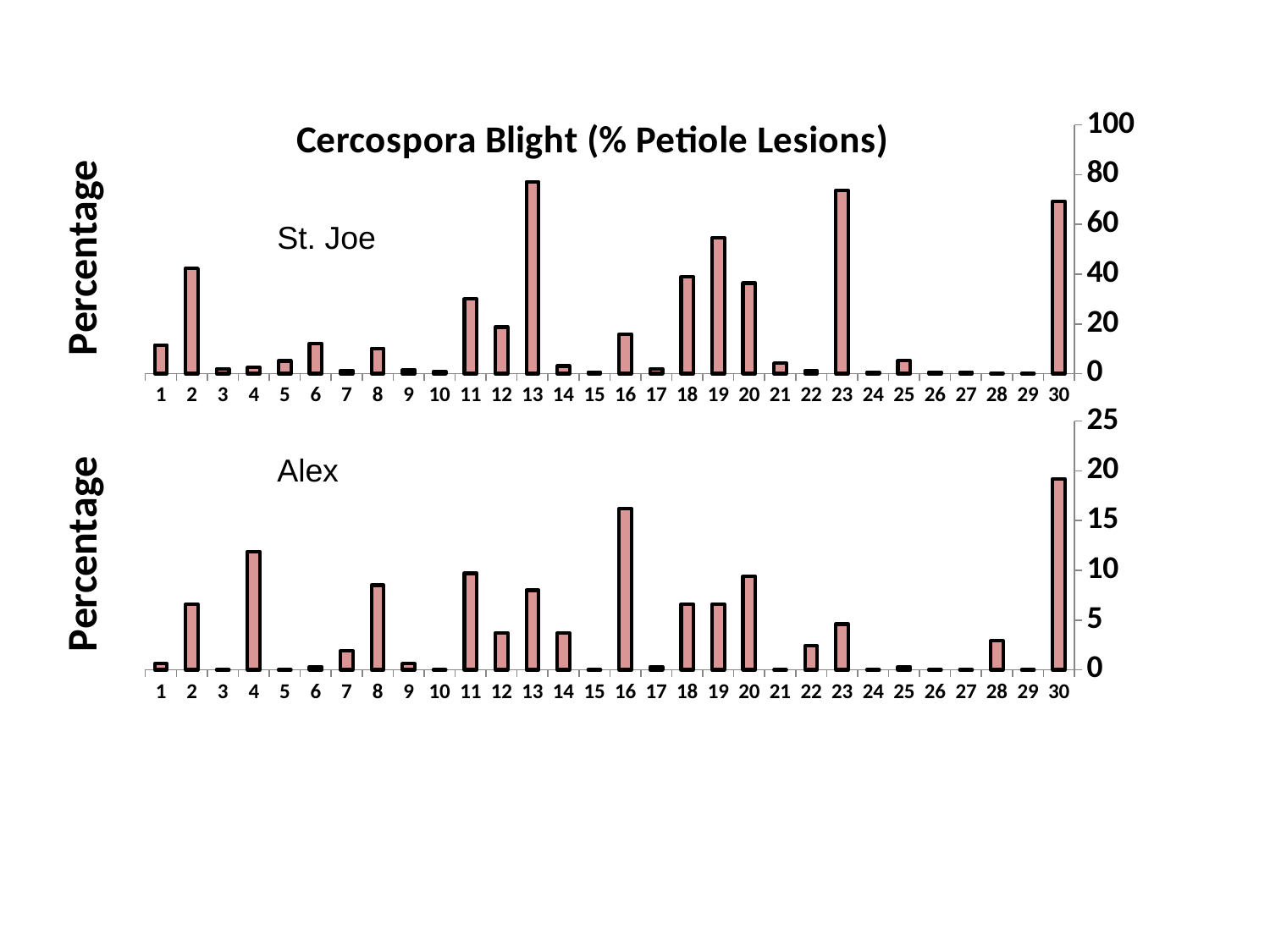
In the Alex chart, is the value for category 4 greater or less than 15? less In the Alex chart, is the value for category 16 greater or less than 10? greater What kind of chart is the St. Joe chart? bar chart In the St. Joe chart, which is larger, the value for category 19 or the value for category 18? 19 In the St. Joe chart, which category has the highest value? 13 In the St. Joe chart, is the value for category 13 greater or less than 60? greater How many categories are shown on the x axis of the Alex chart? 30 What is the label on the y axis of the Alex chart? Percentage In the Alex chart, which is larger, the value for category 16 or the value for category 11? 16 In the Alex chart, which category has the highest value? 30 What is the title shown above the top chart? Cercospora Blight (% Petiole Lesions)